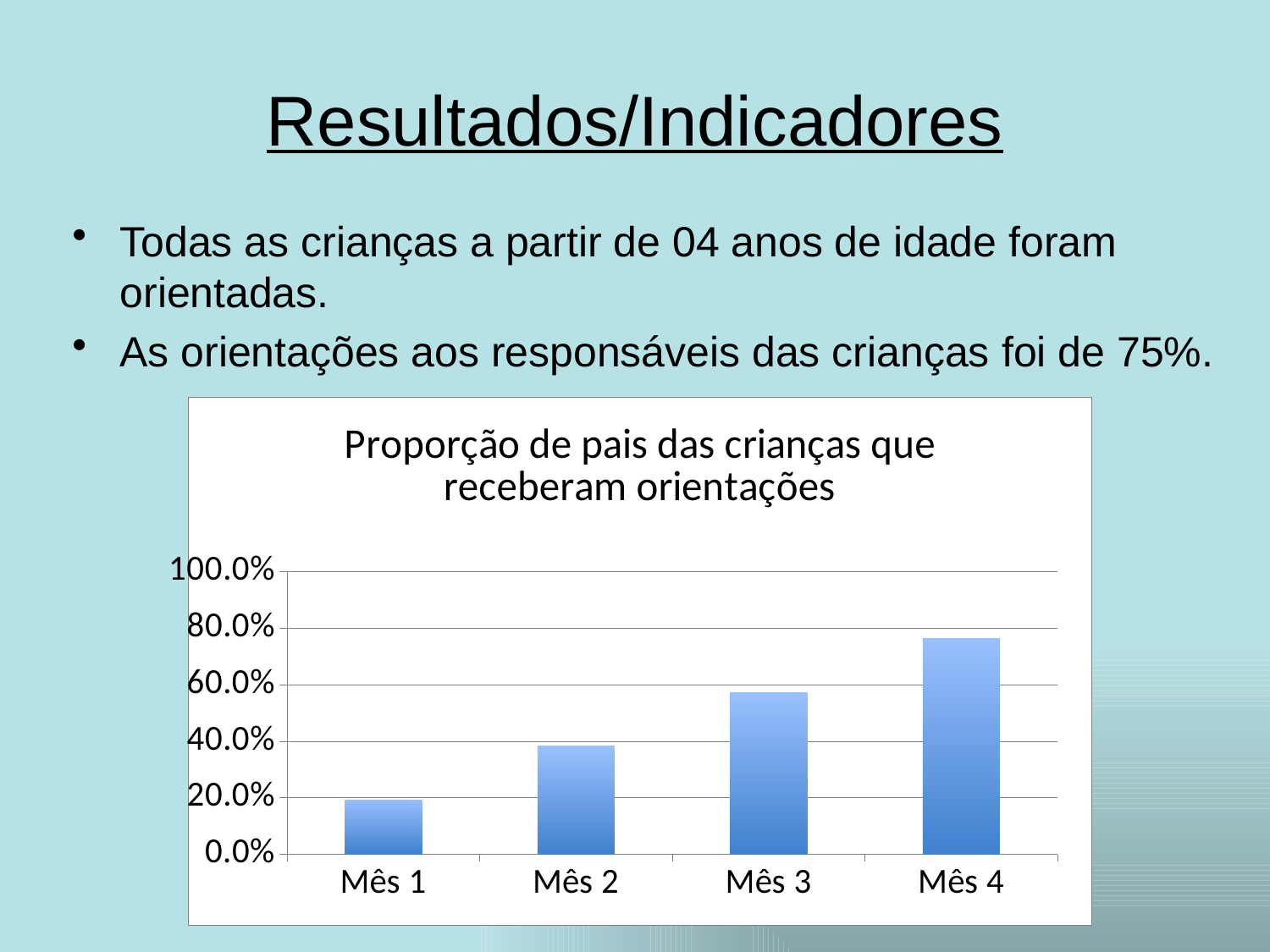
What is the title of the chart? Proporção de pais das crianças que receberam orientações Is the value for Mês 4 greater or less than 60.0%? greater What kind of chart is shown on the slide? bar chart Which month has the highest value in the chart? Mês 4 Do the values rise or fall from Mês 1 to Mês 4? rise Is the value for Mês 2 greater or less than 20.0%? greater Which is larger, the value for Mês 2 or the value for Mês 3? Mês 3 How many categories (months) are shown on the x axis of the chart? 4 Which month has the lowest value in the chart? Mês 1 Is the value for Mês 4 greater or less than 80.0%? less Which is larger, the value for Mês 1 or the value for Mês 4? Mês 4